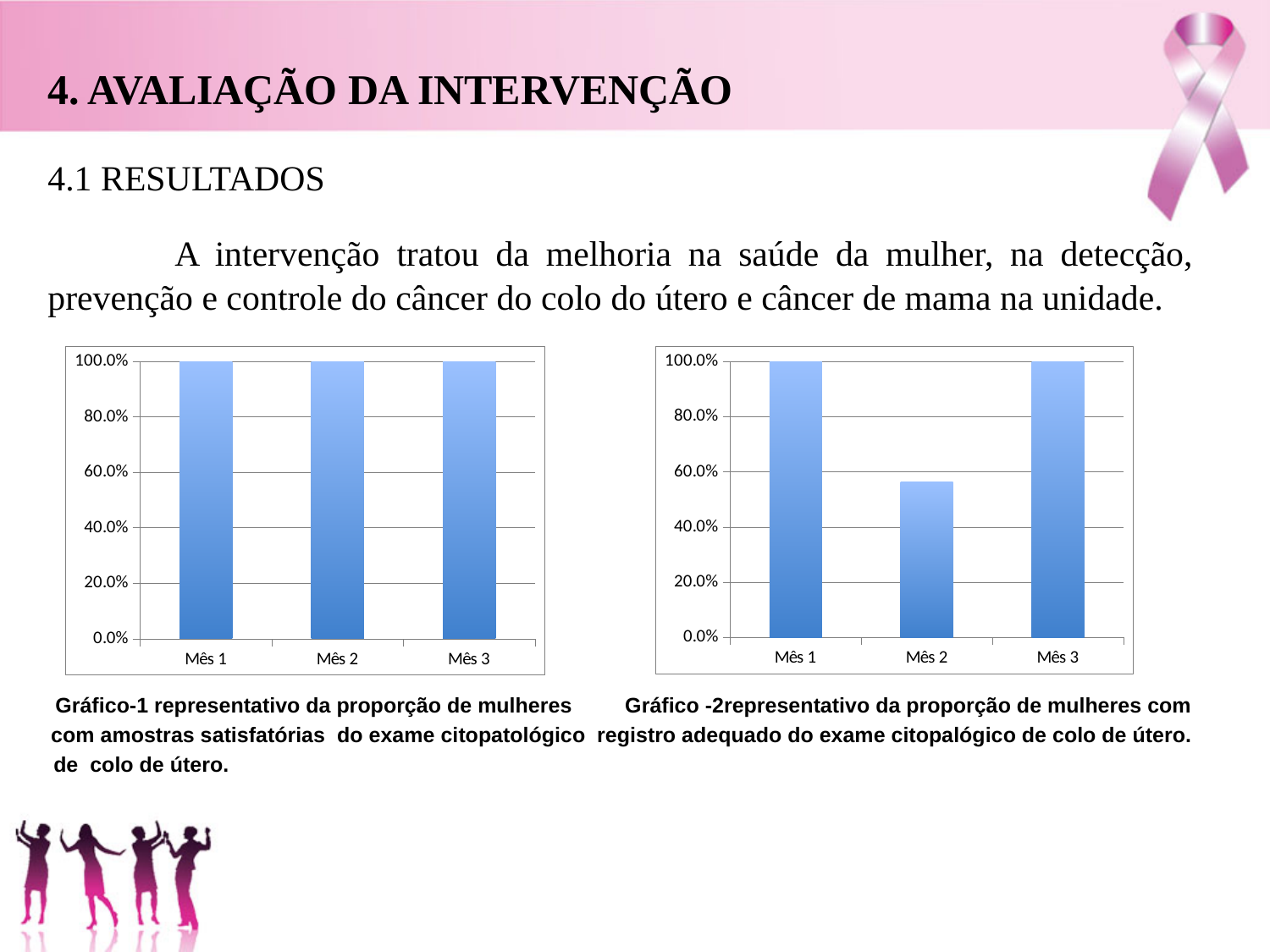
In the left chart, do the values rise, fall or stay the same from Mês 1 to Mês 3? stay the same How many categories are shown on the x axis of the left chart? 3 How many charts are shown on the slide? 2 In the right chart, what is the value for Mês 3? 100.0% What kind of chart is the right chart? bar chart In the right chart, is the value for Mês 2 greater or less than 60.0%? less In the right chart, is the value for Mês 2 greater or less than 40.0%? greater In the left chart, what is the value for Mês 1? 100.0% In the right chart, which is larger, the value for Mês 1 or the value for Mês 2? Mês 1 In the left chart, what is the value for Mês 3? 100.0% In the right chart, what is the value for Mês 1? 100.0% In the right chart, which month has the lowest value? Mês 2